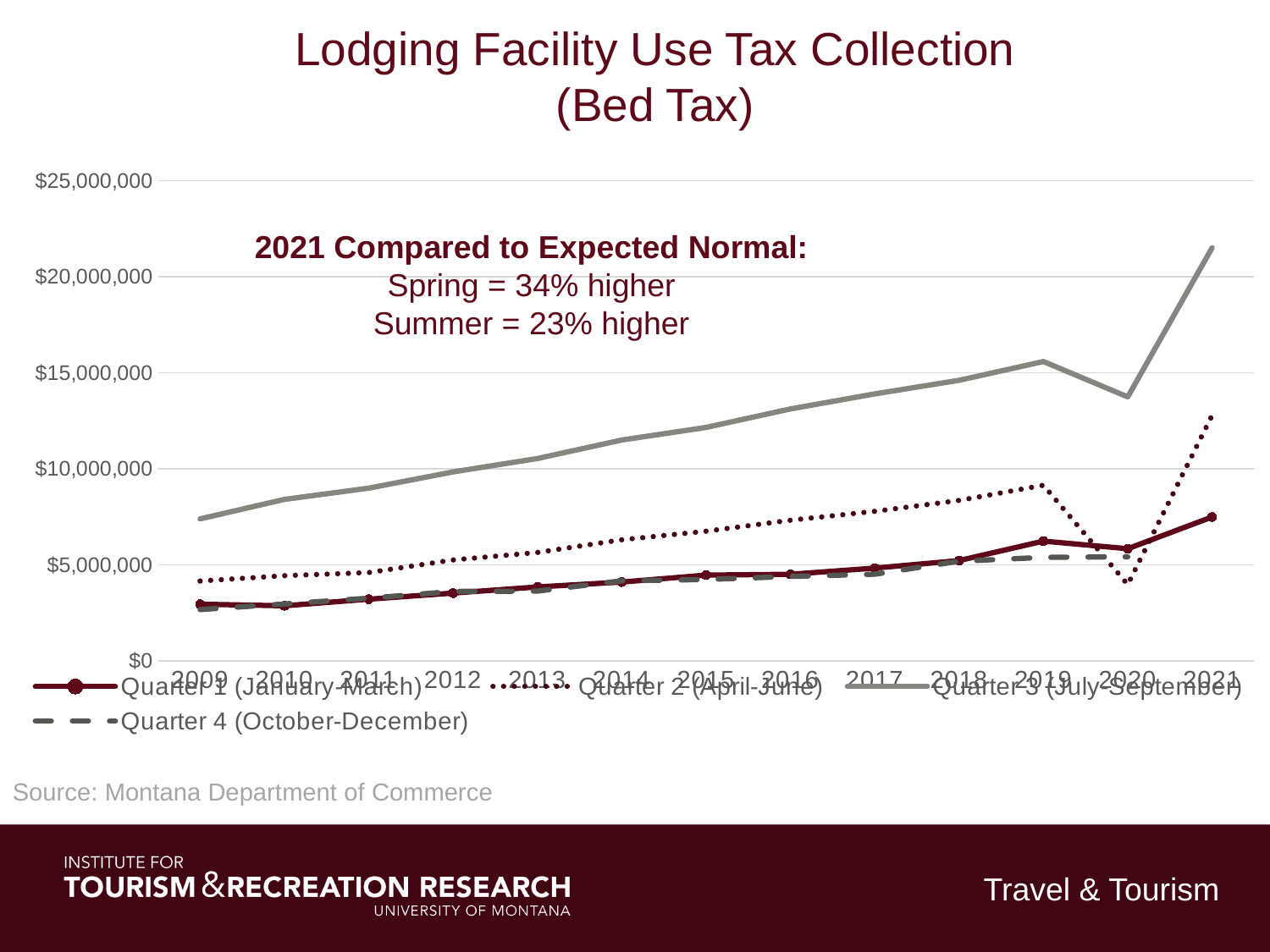
Does the Quarter 3 (July-September) line rise or fall from 2019 to 2020? fall How many years are shown along the x axis? 13 In which year is the Quarter 3 (July-September) line at its highest? 2021 Which quarter has the highest value in 2021? Quarter 3 (July-September) What kind of chart is shown on the slide? line chart How many series does the legend list? 4 Is the value for Quarter 3 (July-September) in 2020 greater or less than $15,000,000? less In which year is the Quarter 3 (July-September) line at its lowest? 2009 Is the value for Quarter 3 (July-September) in 2021 greater or less than $20,000,000? greater Is the value for Quarter 2 (April-June) in 2021 greater or less than $10,000,000? greater In 2019, which is larger: Quarter 2 (April-June) or Quarter 4 (October-December)? Quarter 2 (April-June)